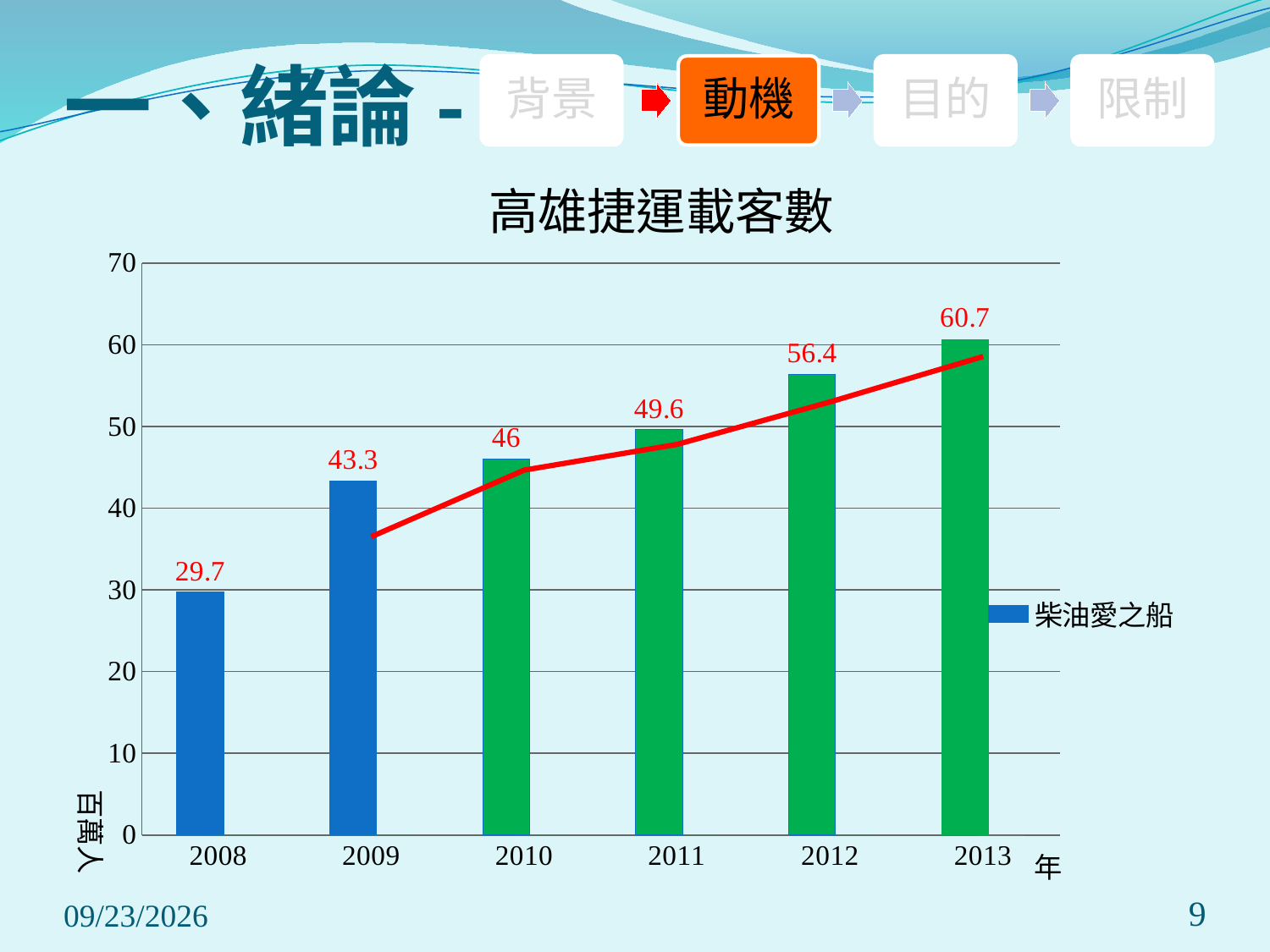
Do the values in the 高雄捷運載客數 chart rise or fall from 2008 to 2013? rise What is the difference between the values for 2013 and 2012 in the 高雄捷運載客數 chart? 4.3 What is the title of the chart on the slide? 高雄捷運載客數 What is the difference between the values for 2009 and 2008 in the 高雄捷運載客數 chart? 13.6 Which year has the highest value in the 高雄捷運載客數 chart? 2013 What is the value for 2011 in the 高雄捷運載客數 chart? 49.6 What is the value for 2008 in the 高雄捷運載客數 chart? 29.7 What is the value for 2013 in the 高雄捷運載客數 chart? 60.7 What kind of chart is the 高雄捷運載客數 chart? bar chart Which is larger in the 高雄捷運載客數 chart, the value for 2010 or the value for 2012? 2012 How many years are shown on the x axis of the 高雄捷運載客數 chart? 6 Which year has the lowest value in the 高雄捷運載客數 chart? 2008